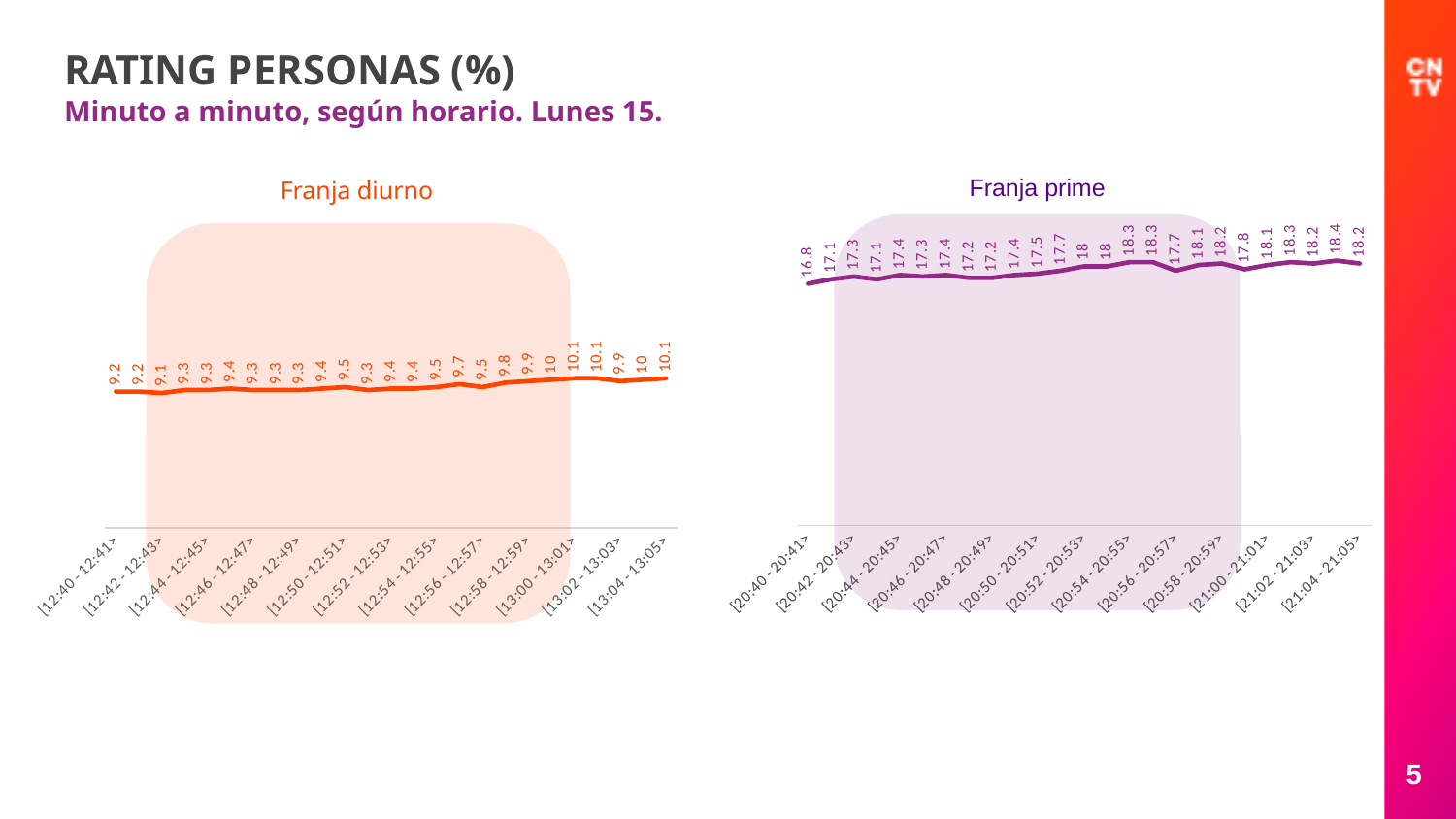
In the 'Franja diurno' chart, what is the rating for [12:40 - 12:41>? 9.2 What kind of chart is the 'Franja diurno' chart? line chart In the 'Franja prime' chart, what is the difference between the rating at [21:04 - 21:05> and the rating at [20:40 - 20:41>? 1.4 In the 'Franja prime' chart, what is the highest rating value shown? 18.4 How many data points are plotted in the 'Franja prime' chart? 25 Which is larger: the rating at [13:04 - 13:05> in the 'Franja diurno' chart or the rating at [20:40 - 20:41> in the 'Franja prime' chart? [20:40 - 20:41> in Franja prime In the 'Franja diurno' chart, what is the rating for [13:04 - 13:05>? 10.1 In the 'Franja prime' chart, what is the rating for [20:40 - 20:41>? 16.8 In the 'Franja prime' chart, what is the rating for [21:04 - 21:05>? 18.2 What is the title of the chart on the right side of the slide? Franja prime In the 'Franja diurno' chart, what is the lowest rating value shown? 9.1 In the 'Franja diurno' chart, do the ratings generally rise or fall from left to right? rise